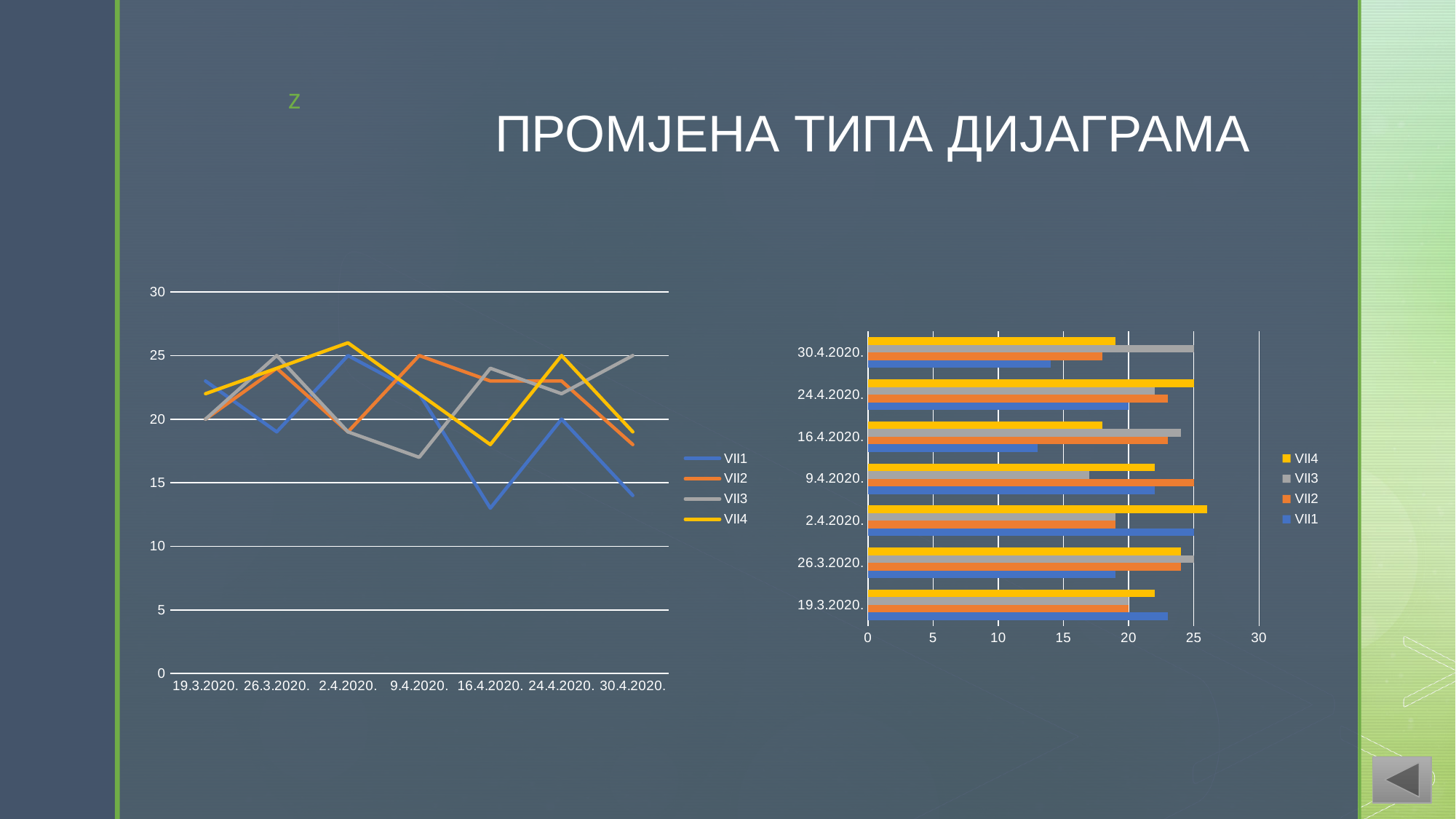
How many date categories are shown on the x axis of the left line chart? 7 In the right bar chart, which series has the longest bar for 2.4.2020.? VII4 What kind of chart is the chart on the left of the slide? line chart In the left line chart, is the value of VII1 for 30.4.2020. greater or less than 15? less In the right bar chart, which series has the shortest bar for 16.4.2020.? VII1 In the right bar chart, is the value of VII1 for 16.4.2020. greater or less than 15? less In the left line chart, does the VII1 line rise or fall between 9.4.2020. and 16.4.2020.? fall How many series does the legend of the left line chart list? 4 In the right bar chart, is the value of VII4 for 2.4.2020. greater or less than 25? greater How many date categories are shown on the right bar chart? 7 What kind of chart is the chart on the right of the slide? bar chart In the left line chart, which is larger for 16.4.2020., VII3 or VII1? VII3